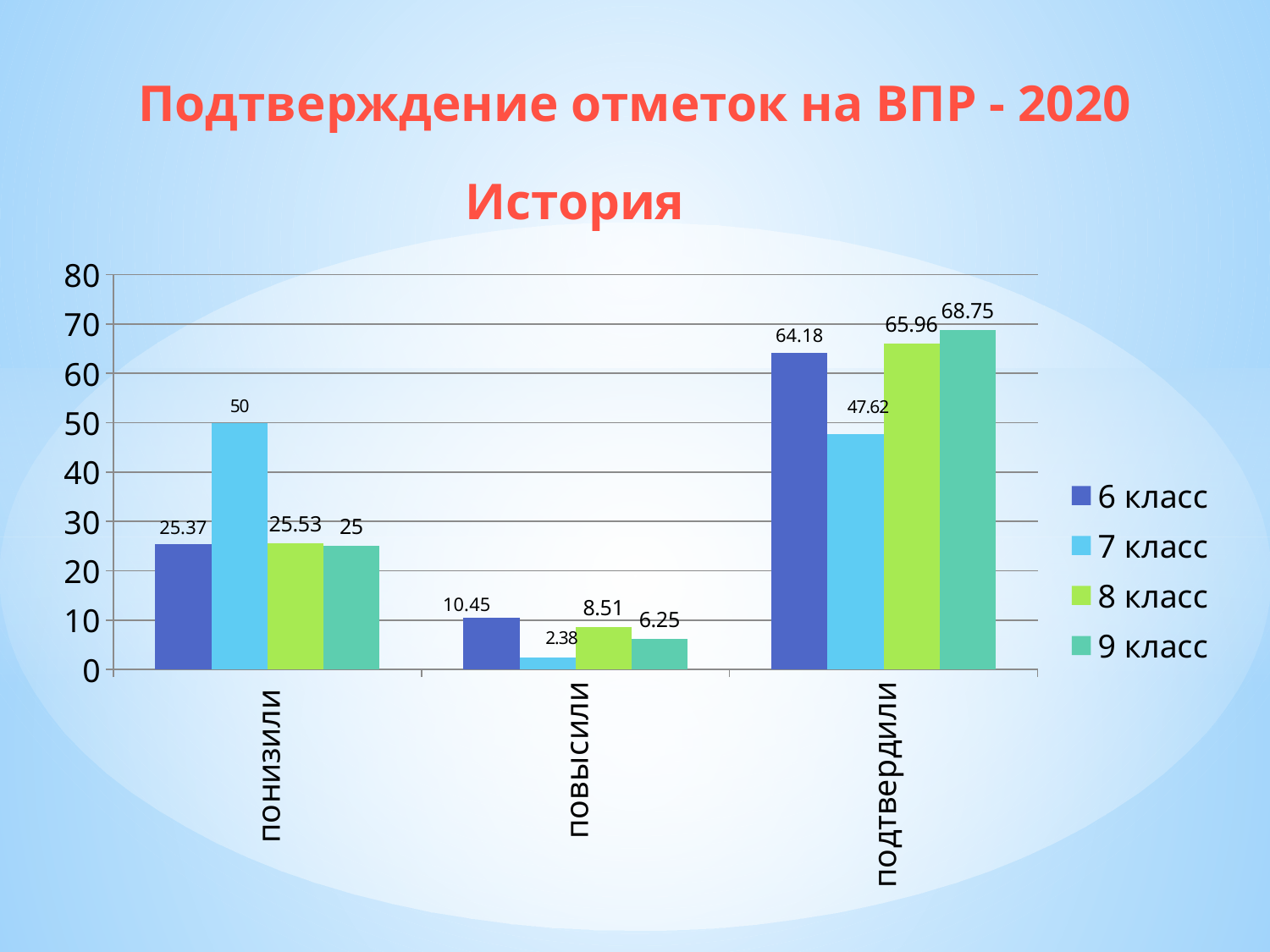
What is the value for 9 класс in the подтвердили category? 68.75 What is the subject named in the chart title below the main heading? История How many series does the legend list? 4 What is the difference between the 6 класс and 7 класс values in the подтвердили category? 16.56 How many categories are shown on the x axis? 3 What is the value for 7 класс in the повысили category? 2.38 Which is larger: the 8 класс value for понизили or the 9 класс value for понизили? 8 класс (25.53) Which series has the highest value in the подтвердили category? 9 класс What is the value for 7 класс in the понизили category? 50 Is the value for 7 класс in the подтвердили category greater or less than 50? less What kind of chart is shown on the slide? bar chart Which series has the lowest value in the повысили category? 7 класс